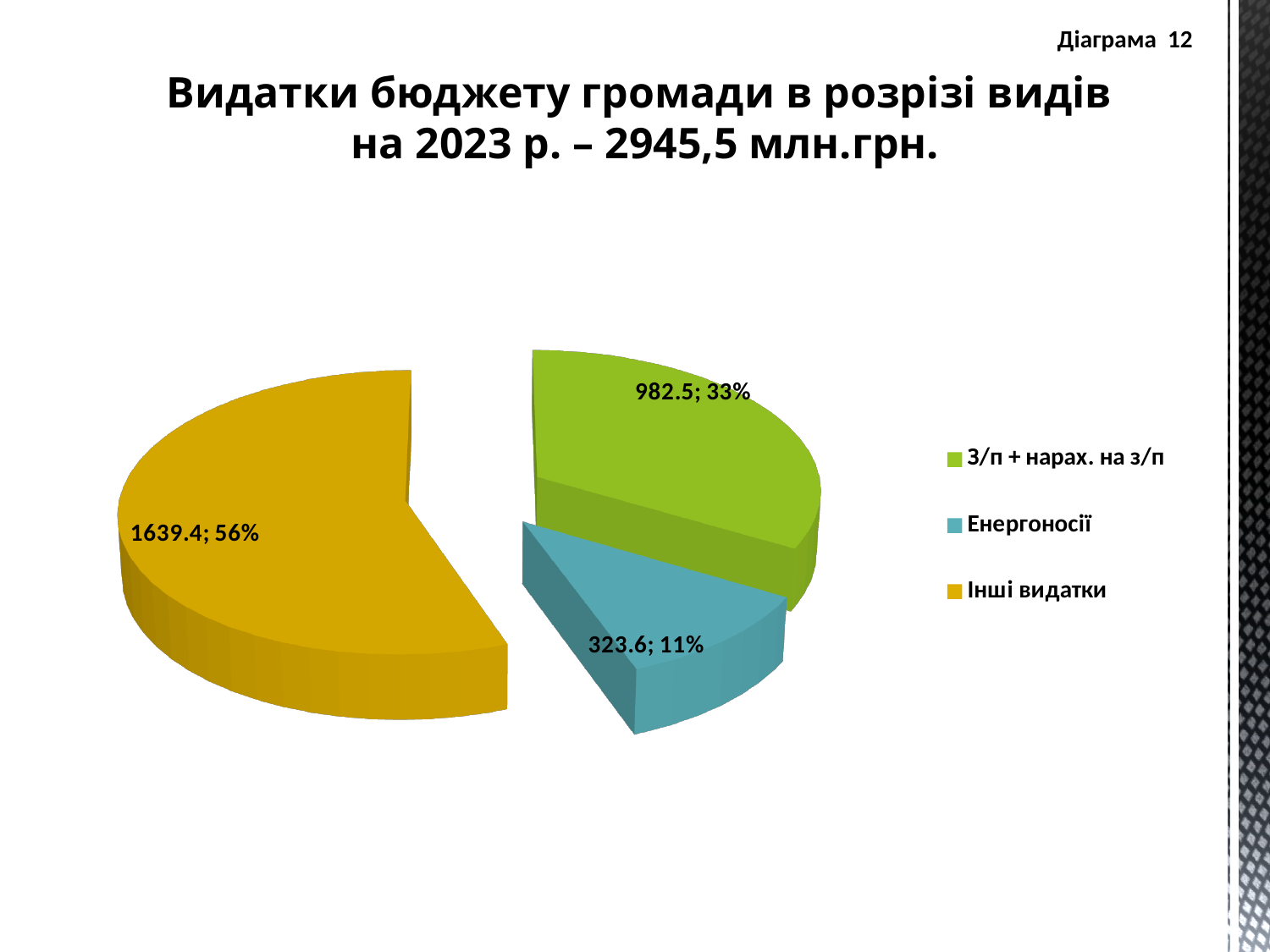
Which category has the smallest slice? Енергоносії What is the value for "З/п + нарах. на з/п"? 982.5 What share of the pie does "З/п + нарах. на з/п" represent? 33% What is the value for "Інші видатки"? 1639.4 What kind of chart is shown on the slide? Pie chart How many categories does the legend list? 3 Which category has the largest slice? Інші видатки What is the value for "Енергоносії"? 323.6 What is the difference between the values for "Інші видатки" and "З/п + нарах. на з/п"? 656.9 Which is larger, the value for "З/п + нарах. на з/п" or the value for "Енергоносії"? З/п + нарах. на з/п What share of the pie does "Енергоносії" represent? 11% What share of the pie does "Інші видатки" represent? 56%